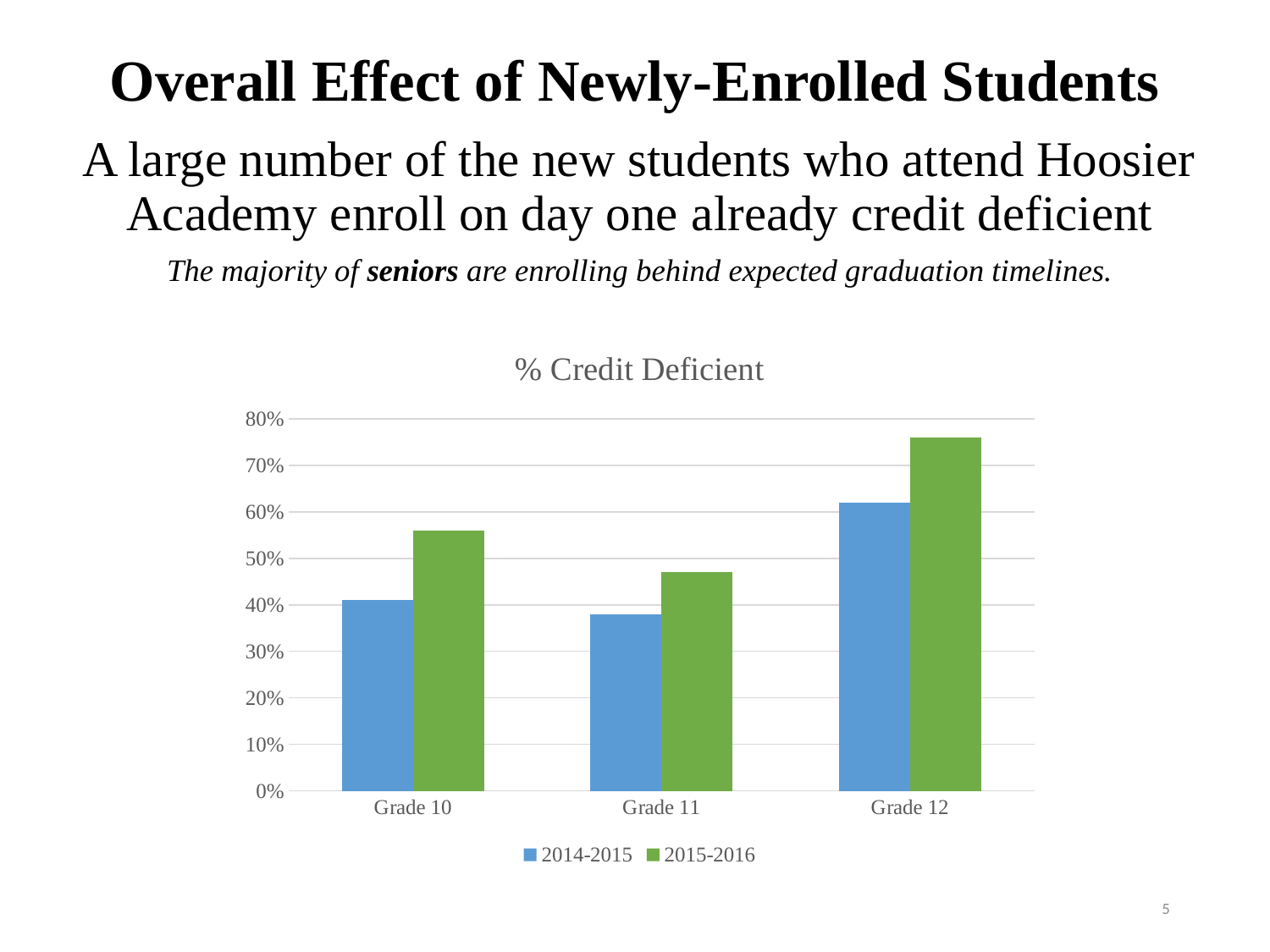
Which grade has the highest value for 2015-2016? Grade 12 Is the value for Grade 10 in 2015-2016 greater or less than 50%? greater What is the title of the chart? % Credit Deficient Which grade has the lowest value for 2014-2015? Grade 11 Is the value for Grade 10 in 2014-2015 greater or less than 50%? less What kind of chart is shown on the slide? bar chart Is the value for Grade 12 in 2015-2016 greater or less than 70%? greater Which colour represents the 2014-2015 series in the legend? blue How many grade categories are shown on the x axis? 3 For Grade 12, which series is larger, 2014-2015 or 2015-2016? 2015-2016 How many series does the legend list? 2